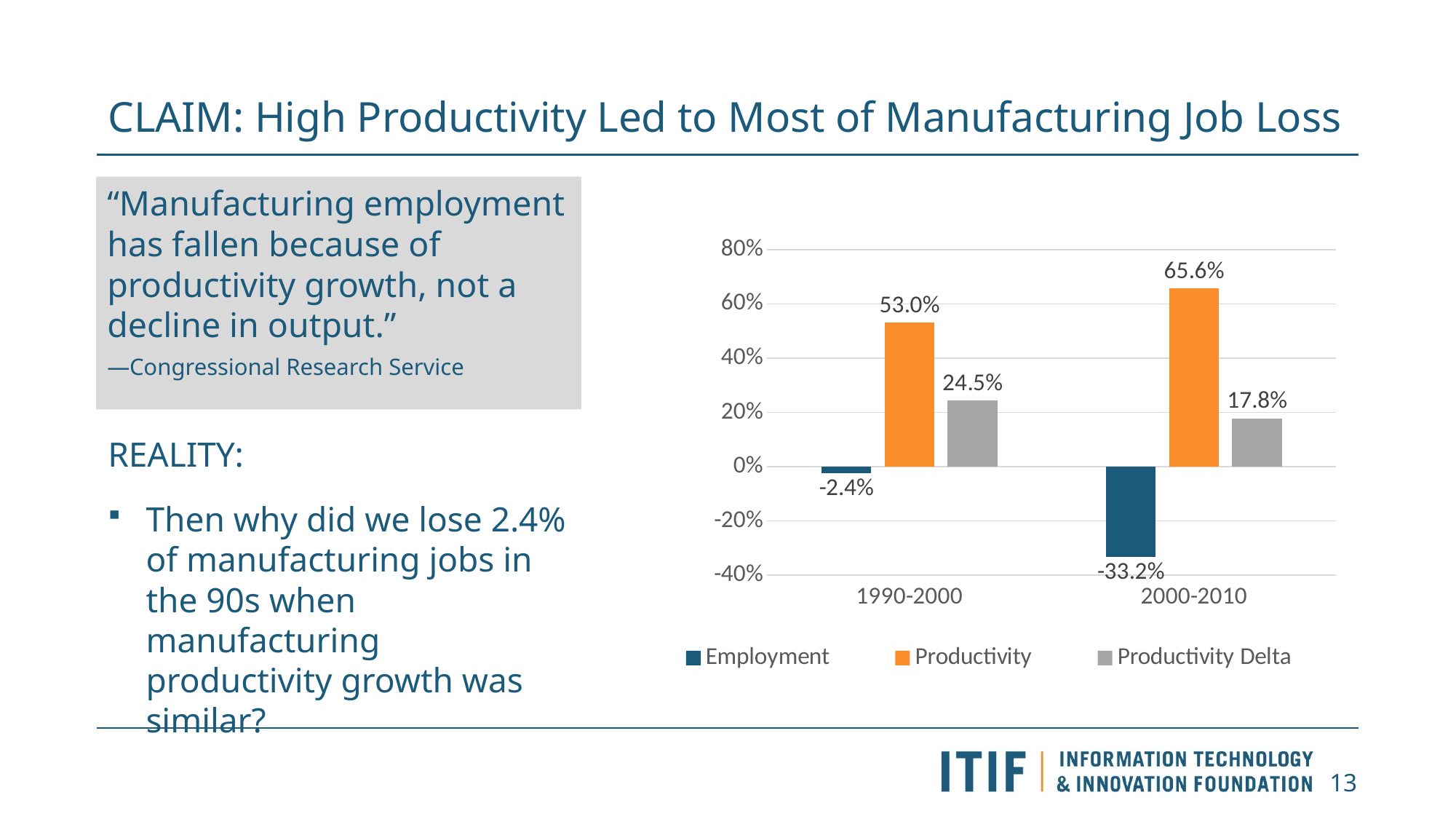
What is the Productivity Delta value for 1990-2000? 24.5% What is the Employment value for 1990-2000? -2.4% What is the Employment value for 2000-2010? -33.2% Is the Productivity Delta larger in 1990-2000 or 2000-2010? 1990-2000 What kind of chart is shown on the slide? Bar chart How many series does the legend list? 3 Which period has the higher Productivity value? 2000-2010 What is the difference between the Productivity values for 2000-2010 and 1990-2000? 12.6% How many periods are shown on the x axis? 2 What colour are the Productivity bars? Orange Which period has the lowest Employment value? 2000-2010 What is the Productivity value for 2000-2010? 65.6%